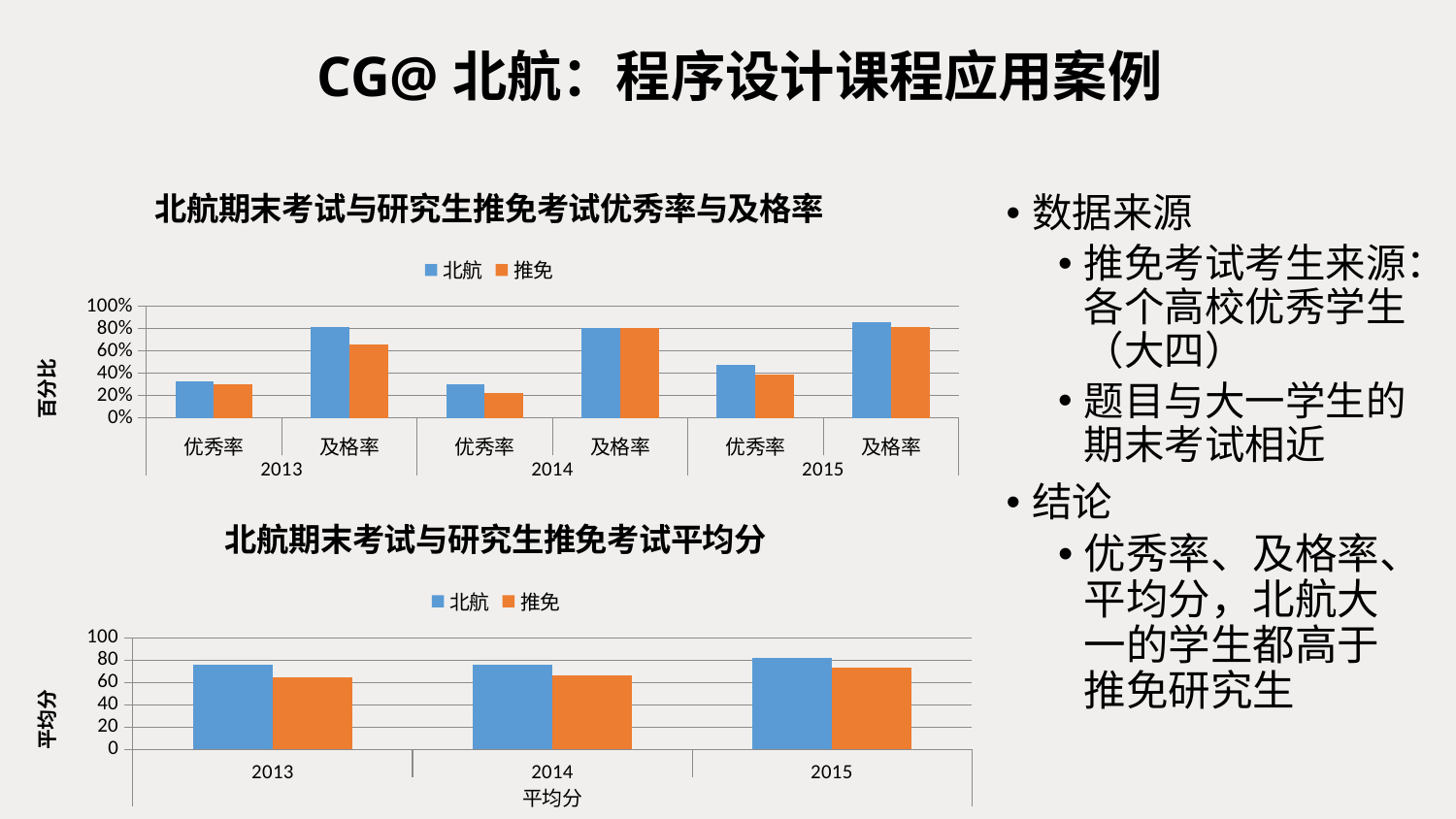
In the top chart (优秀率与及格率), how many series does the legend list? 2 In the bottom chart (平均分), for 2015, which series has the larger value, 北航 or 推免? 北航 In the top chart (优秀率与及格率), is the 推免 value for 优秀率 in 2014 greater or less than 40%? less In the bottom chart (平均分), how many year categories are shown on the x axis? 3 In the top chart (优秀率与及格率), what are the two legend entries? 北航, 推免 In the bottom chart (平均分), is the 北航 value for 2015 greater or less than 60? greater In the top chart (优秀率与及格率), for 优秀率 in 2015, which series has the larger value, 北航 or 推免? 北航 In the bottom chart (平均分), is the 推免 value for 2013 greater or less than 80? less What kind of chart is the top chart titled 北航期末考试与研究生推免考试优秀率与及格率? bar chart In the bottom chart (平均分), do the 推免 values rise or fall from 2013 to 2015? rise In the top chart (优秀率与及格率), for 及格率 in 2013, which series has the larger value, 北航 or 推免? 北航